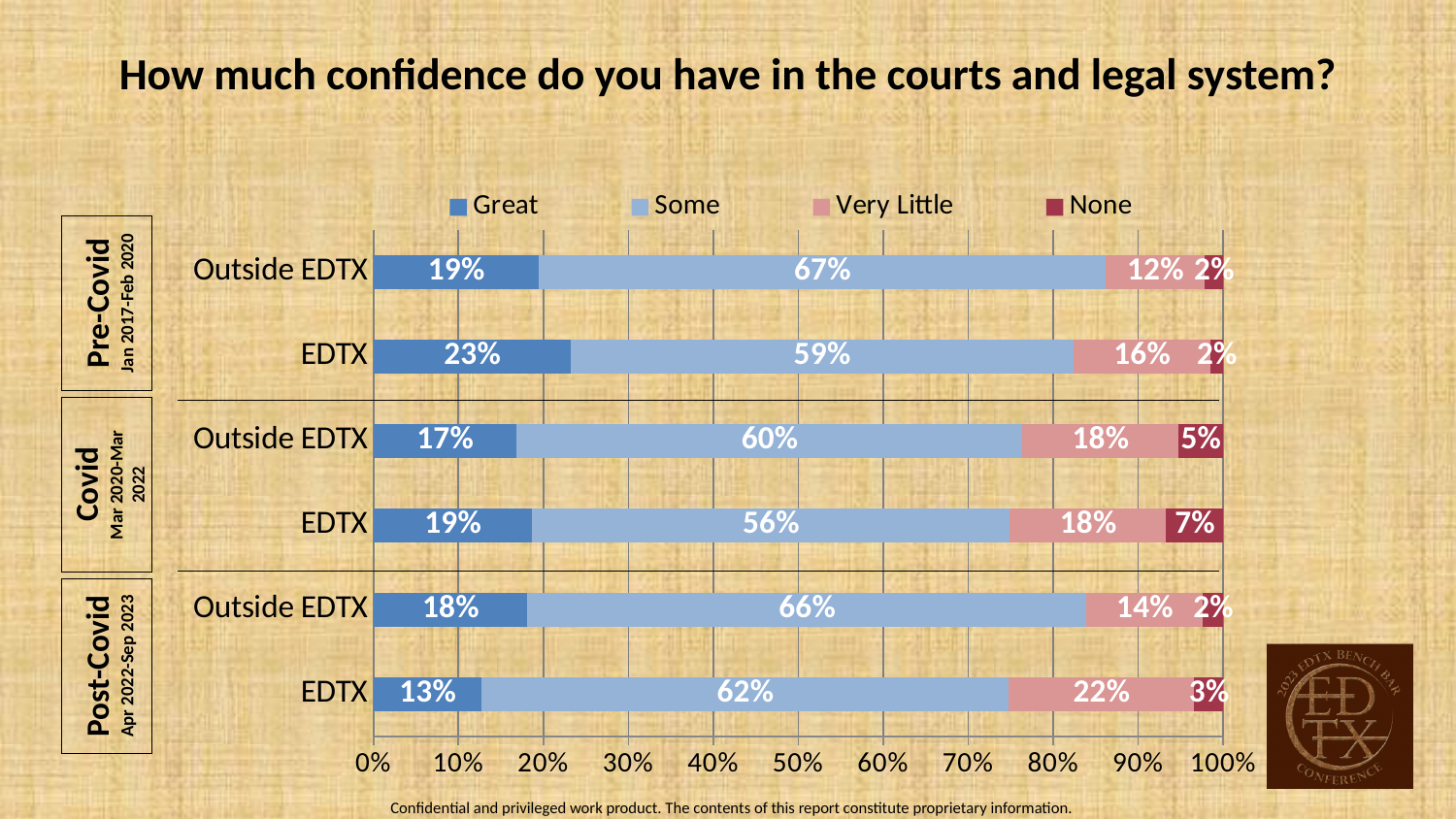
What is the total of the 'Great' and 'Some' segments for Covid EDTX? 75% How many bars (respondent groups) are plotted on the chart? 6 What is the difference between the 'Some' values for Outside EDTX and EDTX in the Pre-Covid period? 8% How many series does the legend list? 4 Which bar has the lowest 'Great' value? Post-Covid EDTX What is the 'Some' value for Outside EDTX in the Pre-Covid period? 67% What is the 'None' value for EDTX during the Covid period? 7% Which is larger: the 'Very Little' value for Post-Covid EDTX or for Post-Covid Outside EDTX? Post-Covid EDTX What percentage of Pre-Covid EDTX respondents reported 'Great' confidence? 23% Which bar has the highest 'Great' value? Pre-Covid EDTX What is the 'Very Little' value for EDTX in the Post-Covid period? 22% What kind of chart is shown on the slide? Stacked bar chart